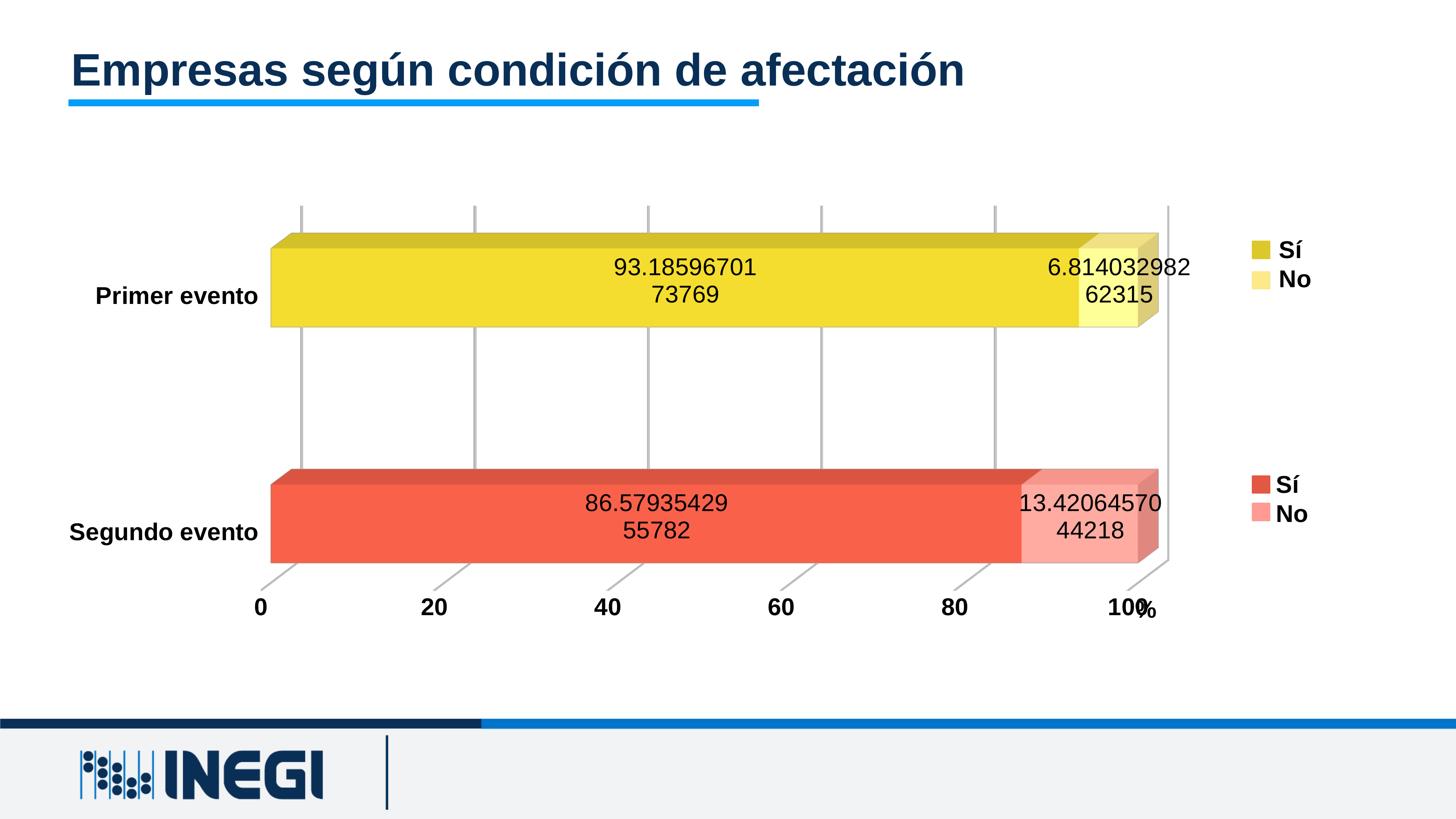
What is the title of the chart? Empresas según condición de afectación Which event has the higher 'No' value? Segundo evento Which event has the higher 'Sí' value? Primer evento What is the value of 'Sí' for Primer evento? 93.1859670173769 What is the value of 'No' for Segundo evento? 13.4206457044218 How many series does the legend list for each event? 2 What is the difference between the 'Sí' values of Primer evento and Segundo evento? 6.6066127217987 What is the value of 'No' for Primer evento? 6.81403298262315 What type of chart is shown on the slide? Stacked bar chart How many categories (events) are shown on the chart? 2 What is the value of 'Sí' for Segundo evento? 86.5793542955782 Is the 'Sí' value for Segundo evento greater or less than 80? greater